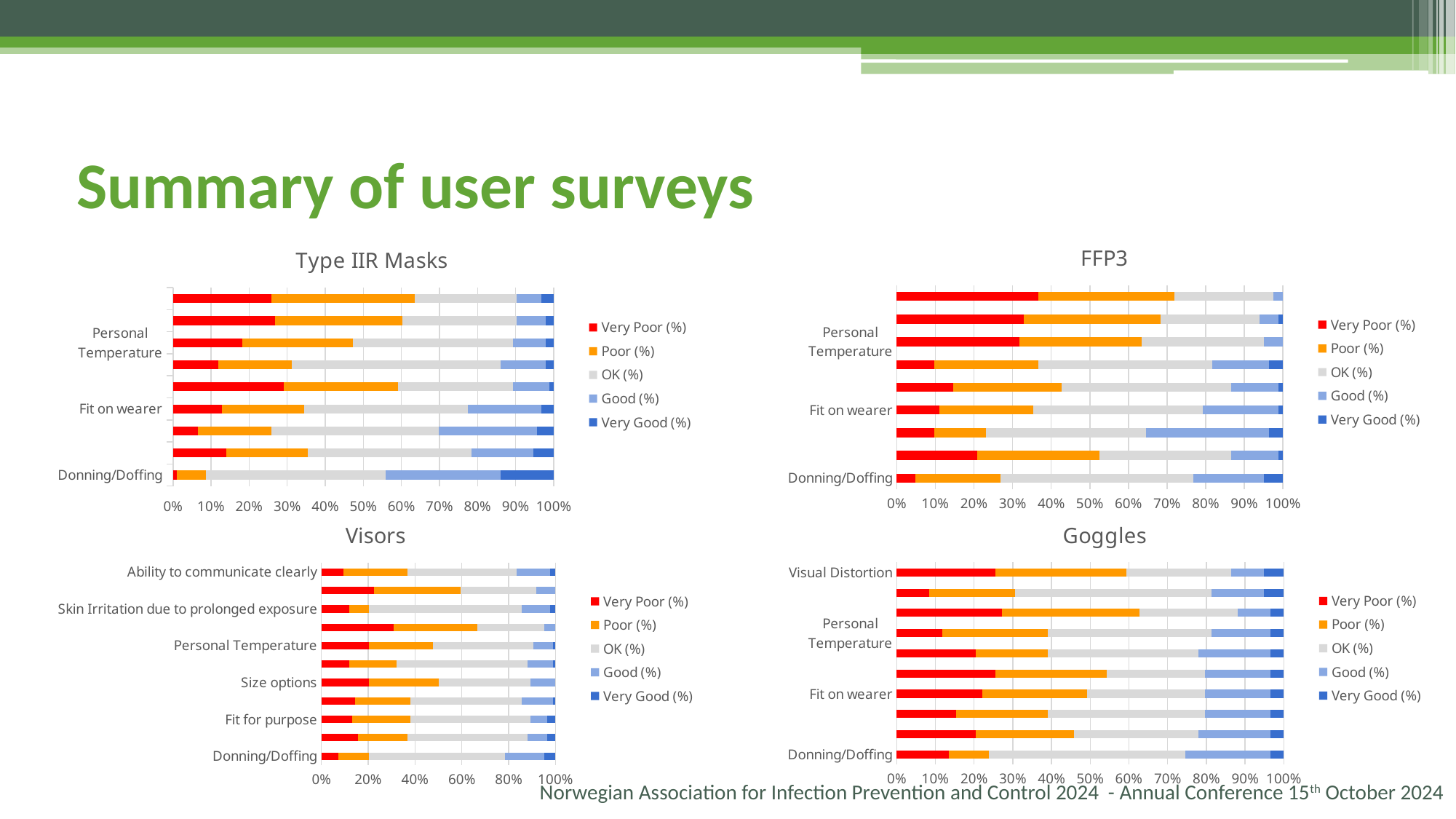
In the Type IIR Masks chart, is the Very Poor (%) value for Donning/Doffing greater or less than 10%? less How many charts are shown on the slide? 4 In the Type IIR Masks chart, is the Good (%) value for Donning/Doffing greater or less than 20%? greater In the Goggles chart, is the Poor (%) value for Visual Distortion greater or less than 30%? greater What is the title of the chart in the bottom-left of the slide? Visors What kind of chart is the Type IIR Masks chart? Stacked bar chart In the Goggles chart, which series is shown in red? Very Poor (%) How many series does the legend of the FFP3 chart list? 5 In the Type IIR Masks chart, for Donning/Doffing, which is larger: the Very Good (%) segment or the Very Poor (%) segment? Very Good (%)